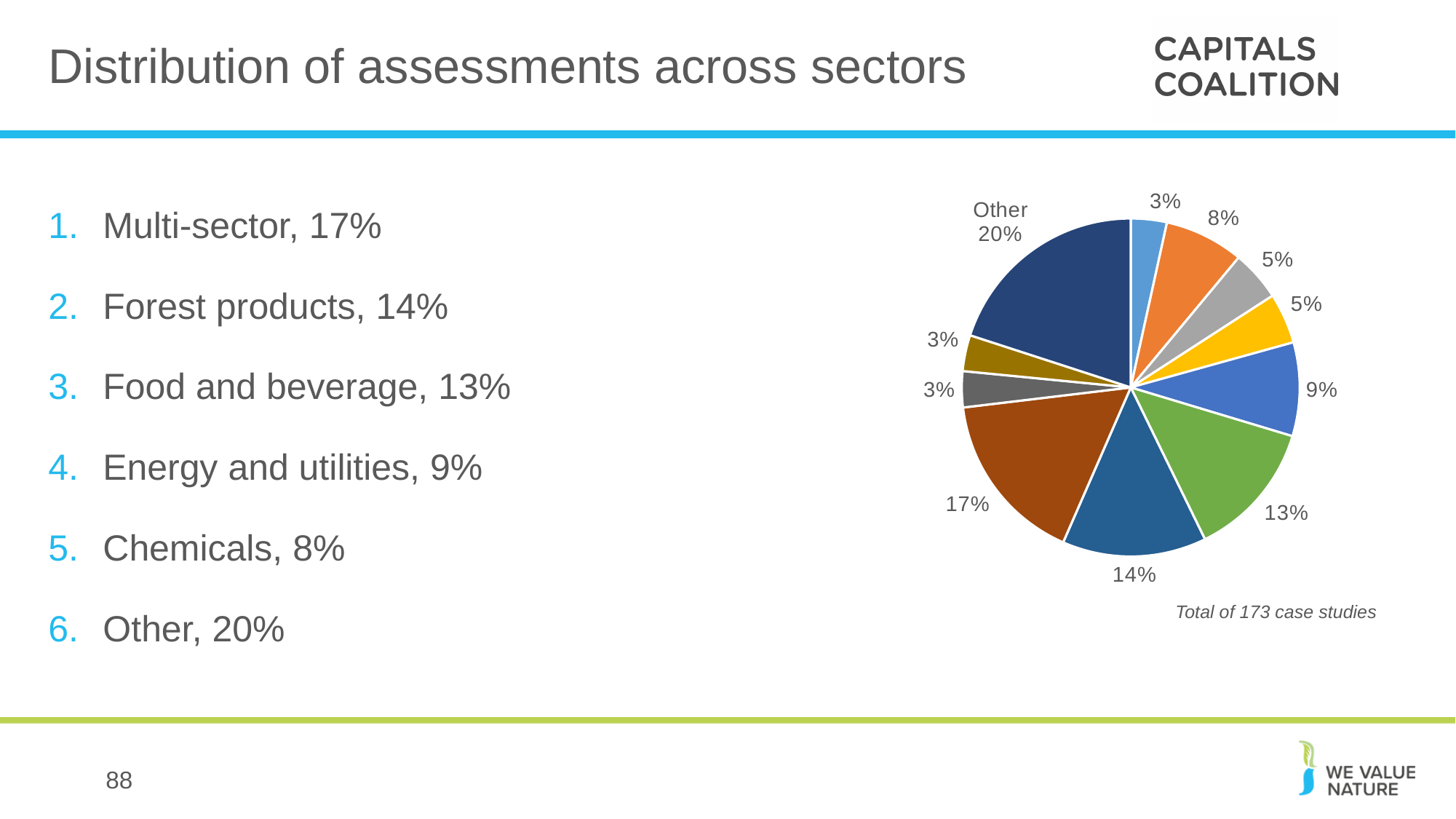
What is the difference between the largest slice (20%) and the second-largest slice (17%) in the pie chart? 3% Which slice of the pie chart is the largest? Other (20%) What share of the pie chart is labelled 'Other'? 20% How many slices does the pie chart have? 11 What is the smallest percentage shown on any slice of the pie chart? 3% According to the slide, which sector accounts for 14% of assessments? Forest products Is the 'Other' slice larger or smaller than the 14% slice? larger What is the title of the slide containing the pie chart? Distribution of assessments across sectors How many slices of the pie chart are labelled 3%? 3 According to the slide, what percentage of assessments is Energy and utilities? 9% According to the note under the pie chart, how many case studies are included in total? 173 What kind of chart is shown on the slide? pie chart